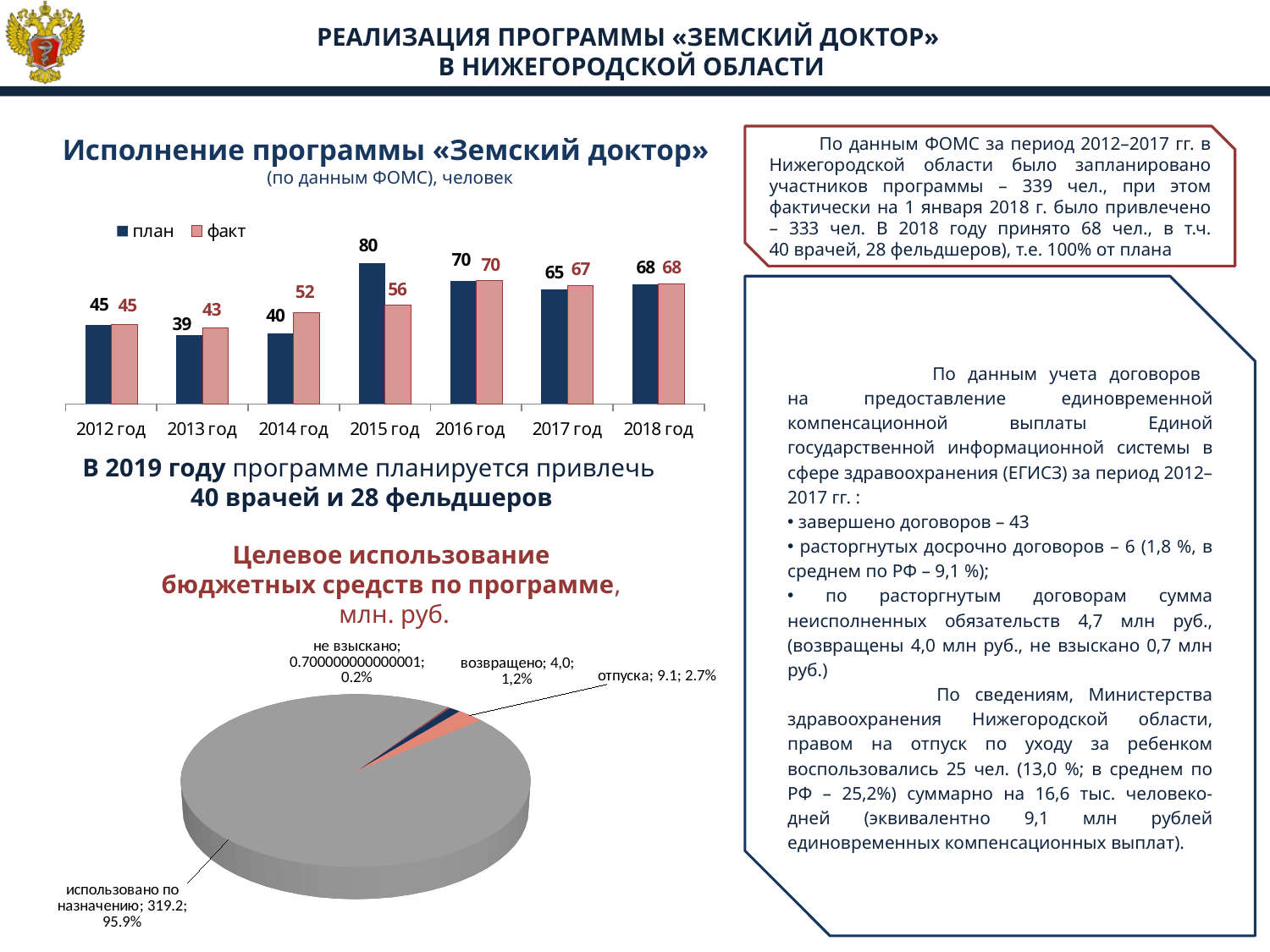
In the bar chart «Исполнение программы «Земский доктор»», what is the факт value for 2014 год? 52 In the bar chart «Исполнение программы «Земский доктор»», which year has the highest план value? 2015 год In the bar chart «Исполнение программы «Земский доктор»», which is larger for 2013 год, план or факт? факт In the bar chart «Исполнение программы «Земский доктор»», what is the difference between план and факт for 2015 год? 24 In the pie chart «Целевое использование бюджетных средств по программе», what is the value for «использовано по назначению»? 319.2 How many series does the legend of the bar chart «Исполнение программы «Земский доктор»» list? 2 What kind of chart is «Исполнение программы «Земский доктор»»? bar chart In the bar chart «Исполнение программы «Земский доктор»», what is the план value for 2015 год? 80 In the pie chart «Целевое использование бюджетных средств по программе», what share does «отпуска» have? 2.7% In the bar chart «Исполнение программы «Земский доктор»», which year has the lowest план value? 2013 год How many years are shown on the x axis of the bar chart «Исполнение программы «Земский доктор»»? 7 What kind of chart is «Целевое использование бюджетных средств по программе»? pie chart